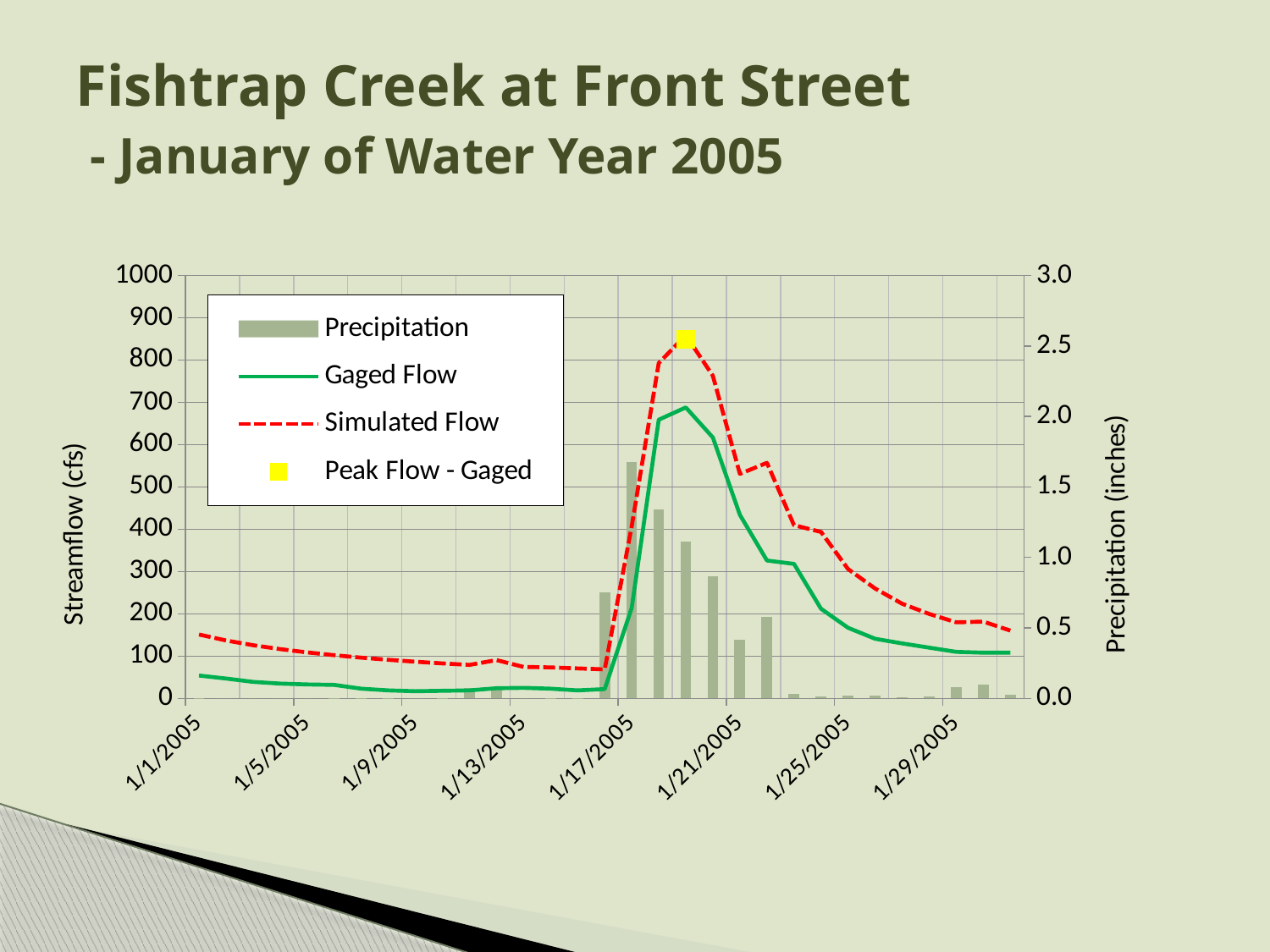
Is the peak value of the Simulated Flow line greater or less than 800 cfs? greater Is the Simulated Flow value on 1/1/2005 greater or less than 100 cfs? greater Which series is drawn as bars? Precipitation Is the peak value of the Gaged Flow line greater or less than 700 cfs? less What kind of chart is this? Combination bar and line chart At the peak around 1/19/2005, which is higher: Simulated Flow or Gaged Flow? Simulated Flow How many series does the legend list? 4 What is the title of the left vertical axis? Streamflow (cfs) Does the Gaged Flow rise or fall from 1/21/2005 to 1/29/2005? fall On which date is the Precipitation bar highest? 1/17/2005